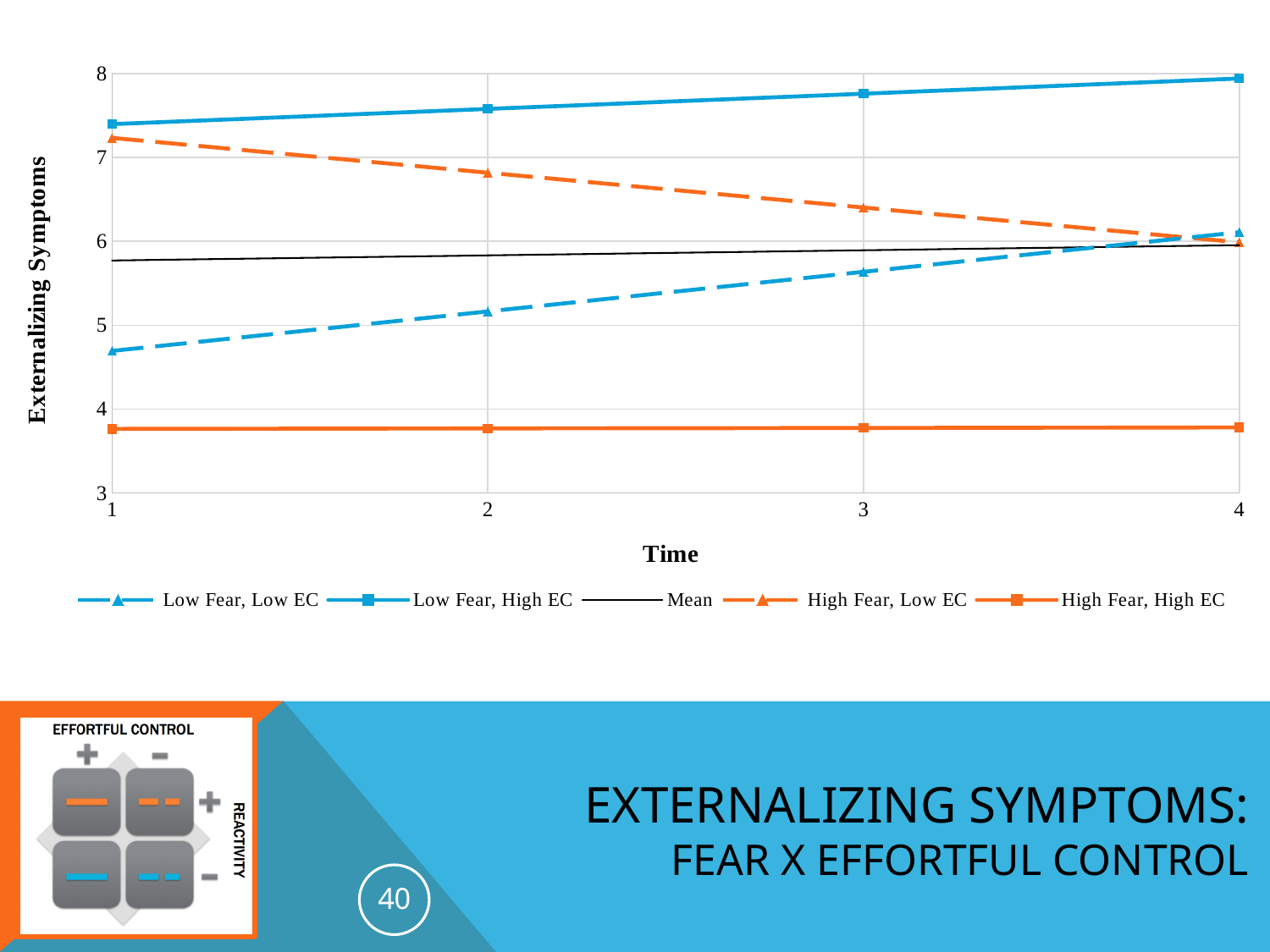
Is the value for Low Fear, Low EC at Time 1 greater or less than 5? less Is the value for Low Fear, High EC at Time 3 greater or less than 7? greater Is the value for High Fear, High EC at Time 4 greater or less than 4? less What kind of chart is shown on the slide? line chart Does the Low Fear, High EC line rise or fall from Time 1 to Time 4? rise Which series has the highest value at Time 4? Low Fear, High EC How many series does the legend list? 5 Does the High Fear, Low EC line rise or fall from Time 1 to Time 4? fall How many time points are plotted along the x axis? 4 Does the Low Fear, Low EC line rise or fall from Time 1 to Time 4? rise At Time 2, which is larger: Low Fear, High EC or High Fear, Low EC? Low Fear, High EC Which series has the lowest value at Time 4? High Fear, High EC